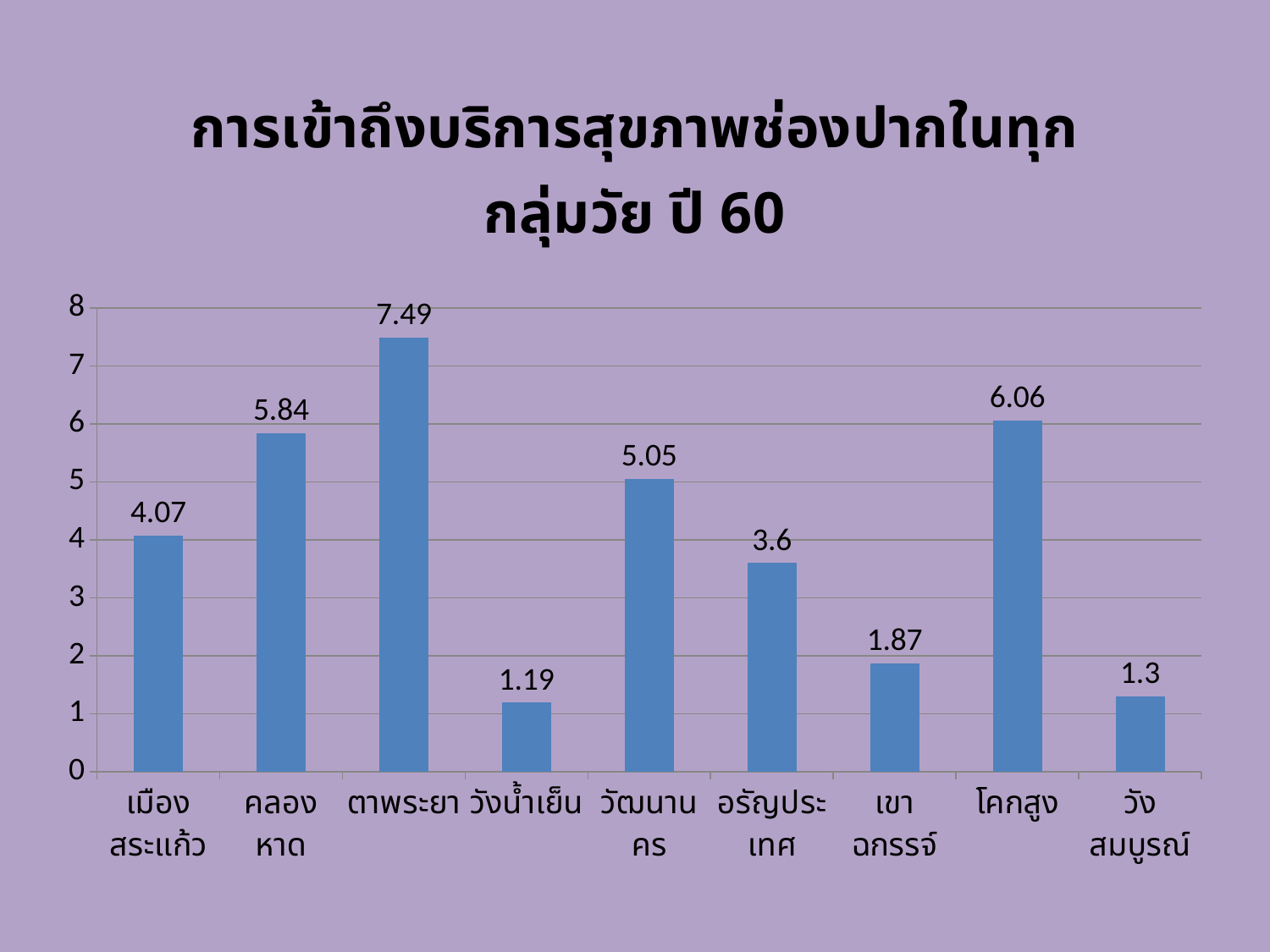
Which category has the lowest value? วังน้ำเย็น What is the title of the chart? การเข้าถึงบริการสุขภาพช่องปากในทุกกลุ่มวัย ปี 60 What is the value for วังสมบูรณ์? 1.3 Which is larger, the value for วัฒนานคร or the value for อรัญประเทศ? วัฒนานคร What is the difference between the values for โคกสูง and คลองหาด? 0.22 What is the value for เขาฉกรรจ์? 1.87 What is the difference between the values for ตาพระยา and วังน้ำเย็น? 6.3 How many categories are shown on the x axis? 9 What is the value for ตาพระยา? 7.49 Is the value for เมืองสระแก้ว greater or less than 4? greater What kind of chart is shown on the slide? bar chart Which category has the highest value? ตาพระยา